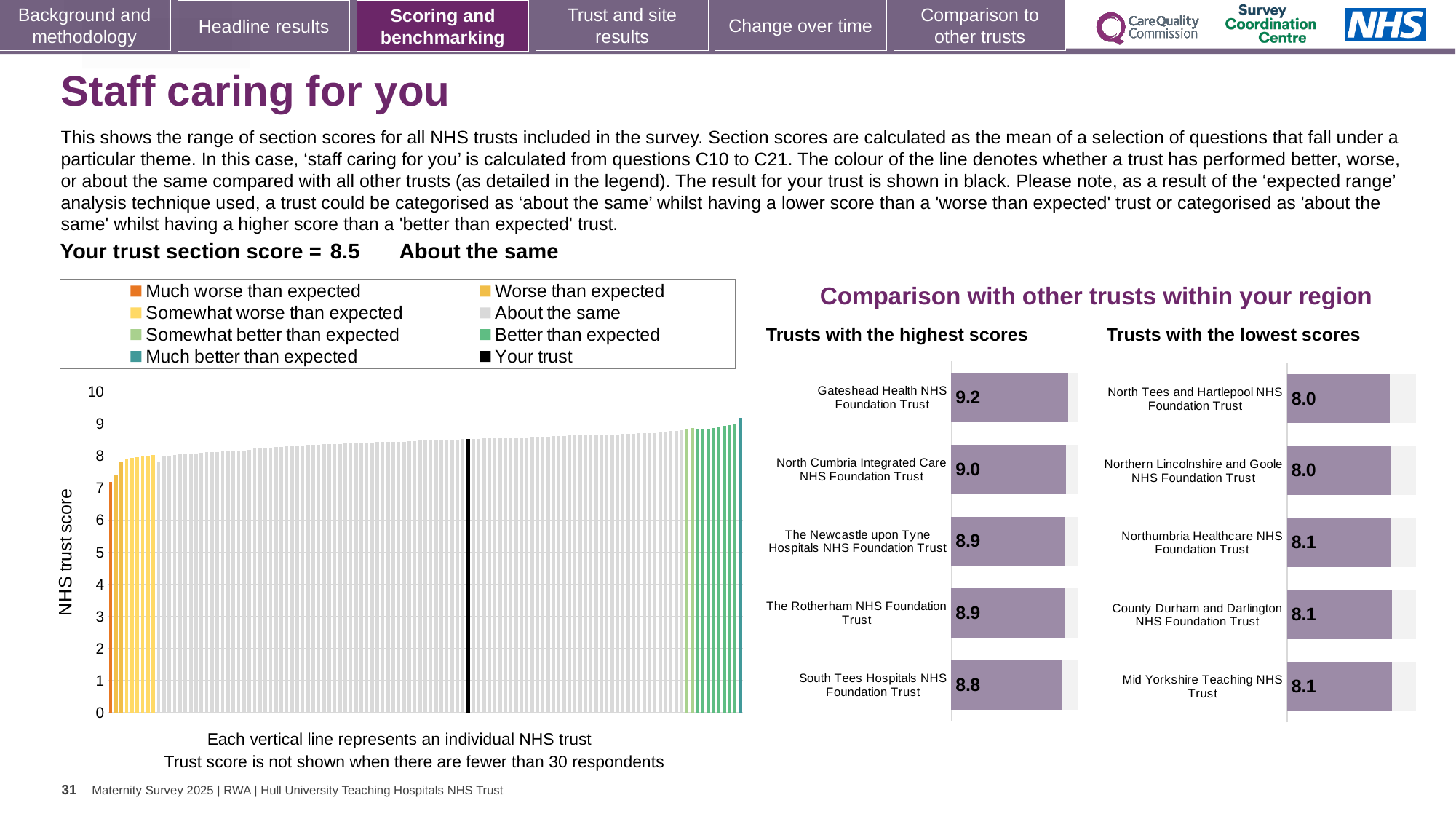
In the 'Trusts with the highest scores' chart, what is the score for Gateshead Health NHS Foundation Trust? 9.2 In the 'Trusts with the highest scores' chart, what is the score for South Tees Hospitals NHS Foundation Trust? 8.8 In the 'Trusts with the highest scores' chart, what is the difference between the scores of Gateshead Health NHS Foundation Trust and South Tees Hospitals NHS Foundation Trust? 0.4 How many entries does the legend above the left-hand chart list? 8 How many trusts are shown in the 'Trusts with the lowest scores' chart? 5 In the 'Trusts with the highest scores' chart, which trust has the lowest score? South Tees Hospitals NHS Foundation Trust In the 'Trusts with the lowest scores' chart, what is the score for Mid Yorkshire Teaching NHS Trust? 8.1 What is the section score for your trust shown on the slide? 8.5 In the 'Trusts with the lowest scores' chart, what is the score for North Tees and Hartlepool NHS Foundation Trust? 8.0 In the 'Trusts with the highest scores' chart, which has the larger score: North Cumbria Integrated Care NHS Foundation Trust or The Newcastle upon Tyne Hospitals NHS Foundation Trust? North Cumbria Integrated Care NHS Foundation Trust In the 'Trusts with the highest scores' chart, which trust has the highest score? Gateshead Health NHS Foundation Trust What kind of chart is the large chart on the left showing NHS trust scores? Bar chart